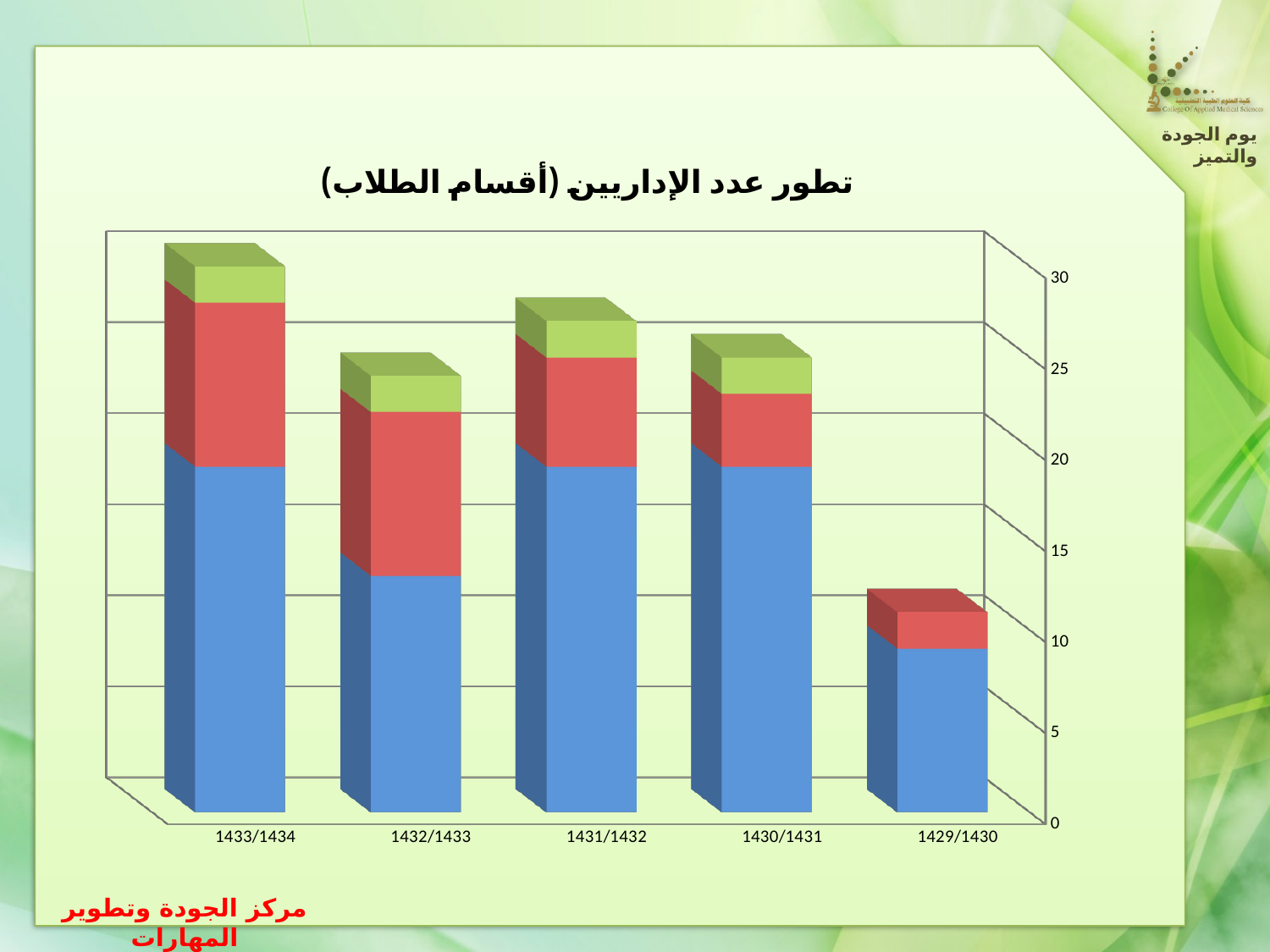
Which academic year's bar has no green segment? 1429/1430 Is the total of the stacked bar for 1429/1430 greater or less than 15? less Which academic year has the tallest stacked bar? 1433/1434 Is the blue segment for 1433/1434 greater or less than 15? greater Is the blue segment for 1432/1433 greater or less than 15? less How many categories (academic years) are shown on the x axis? 5 What kind of chart is shown on the slide? stacked bar chart Reading the x axis from left (1433/1434) to right (1429/1430), do the bar totals generally rise or fall? fall Which stacked bar is taller, 1431/1432 or 1432/1433? 1431/1432 Which academic year has the shortest stacked bar? 1429/1430